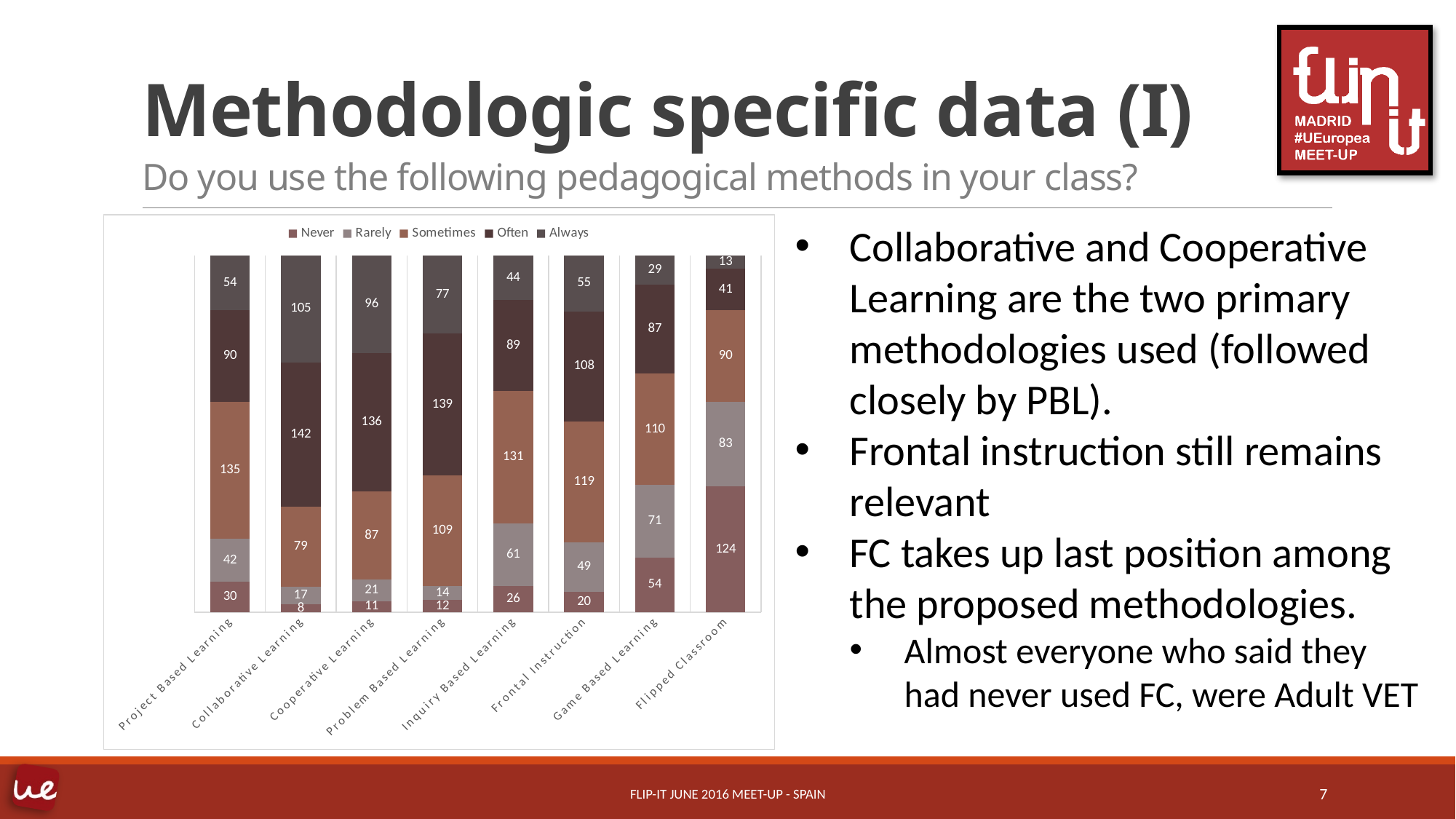
What is the 'Never' value for Flipped Classroom? 124 What is the total of the stacked bar for Flipped Classroom? 351 What is the 'Sometimes' value for Project Based Learning? 135 What type of chart is shown on the slide? Stacked bar chart What is the difference between the 'Often' values for Collaborative Learning and Cooperative Learning? 6 Which is larger: the 'Rarely' value for Game Based Learning or the 'Rarely' value for Inquiry Based Learning? Game Based Learning Which method has the highest 'Always' value? Collaborative Learning Which method has the lowest 'Never' value? Collaborative Learning How many pedagogical methods (categories) are shown on the x axis? 8 Which legend entry is listed first? Never How many series does the legend list? 5 What is the 'Often' value for Collaborative Learning? 142